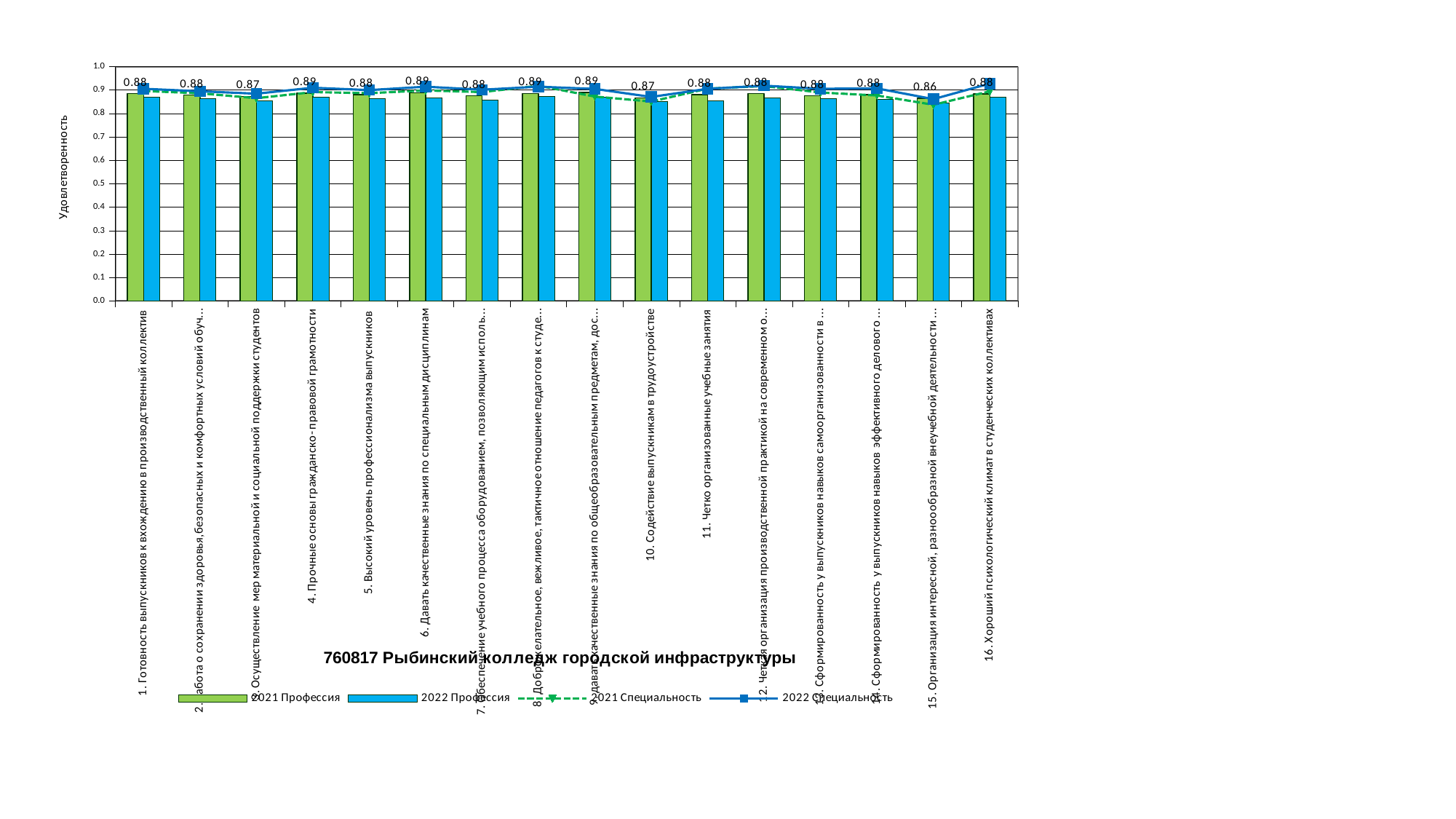
Is the 2022 Профессия value for category 16 (Хороший психологический климат в студенческих коллективах) greater or less than 0.8? greater How many series does the legend list? 4 What is the difference between the 2021 Профессия values for category 4 and category 15? 0.03 What is the 2021 Профессия value for category 4 (Прочные основы гражданско-правовой грамотности)? 0.89 What is the title of the chart? 760817 Рыбинский колледж городской инфраструктуры What kind of chart is shown on the slide? bar and line chart What is the 2021 Профессия value for category 1 (Готовность выпускников к вхождению в производственный коллектив)? 0.88 Which category has the lowest labelled 2021 Профессия value? 15. Организация интересной, разнообразной внеучебной деятельности How many categories are plotted along the x axis? 16 What is the 2021 Профессия value for category 10 (Содействие выпускникам в трудоустройстве)? 0.87 Which has the larger 2021 Профессия value: category 4 or category 10? category 4 What is the 2021 Профессия value for category 15 (Организация интересной, разнообразной внеучебной деятельности)? 0.86